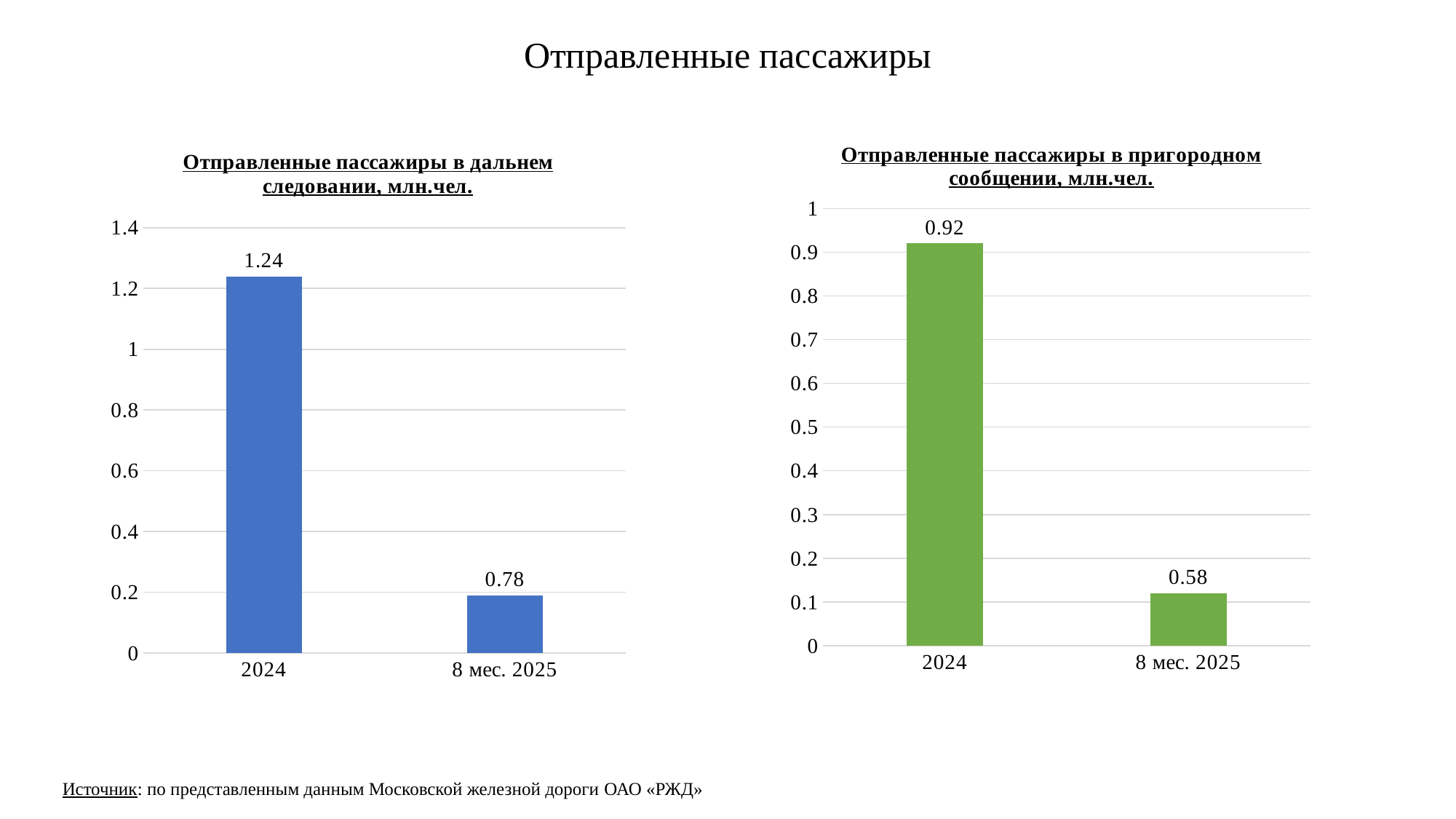
Which is larger: the 2024 value in the left chart (дальнем следовании) or the 2024 value in the right chart (пригородном сообщении)? The left chart (дальнем следовании), 1.24 What kind of chart is the left chart (Отправленные пассажиры в дальнем следовании)? Bar chart In the right chart (Отправленные пассажиры в пригородном сообщении), what is the value for 2024? 0.92 In the left chart (Отправленные пассажиры в дальнем следовании), what is the value for 8 мес. 2025? 0.78 In the left chart (Отправленные пассажиры в дальнем следовании), what is the difference between the 2024 value and the 8 мес. 2025 value? 0.46 In the right chart (Отправленные пассажиры в пригородном сообщении), what is the value for 8 мес. 2025? 0.58 In the right chart (Отправленные пассажиры в пригородном сообщении), what is the difference between the 2024 value and the 8 мес. 2025 value? 0.34 How many categories are shown in the right chart (Отправленные пассажиры в пригородном сообщении)? 2 In the left chart (Отправленные пассажиры в дальнем следовании), is the value for 2024 greater or less than 1? greater In the left chart (Отправленные пассажиры в дальнем следовании), which category has the highest value? 2024 In the right chart (Отправленные пассажиры в пригородном сообщении), which category has the lowest value? 8 мес. 2025 In the left chart (Отправленные пассажиры в дальнем следовании), what is the value for 2024? 1.24